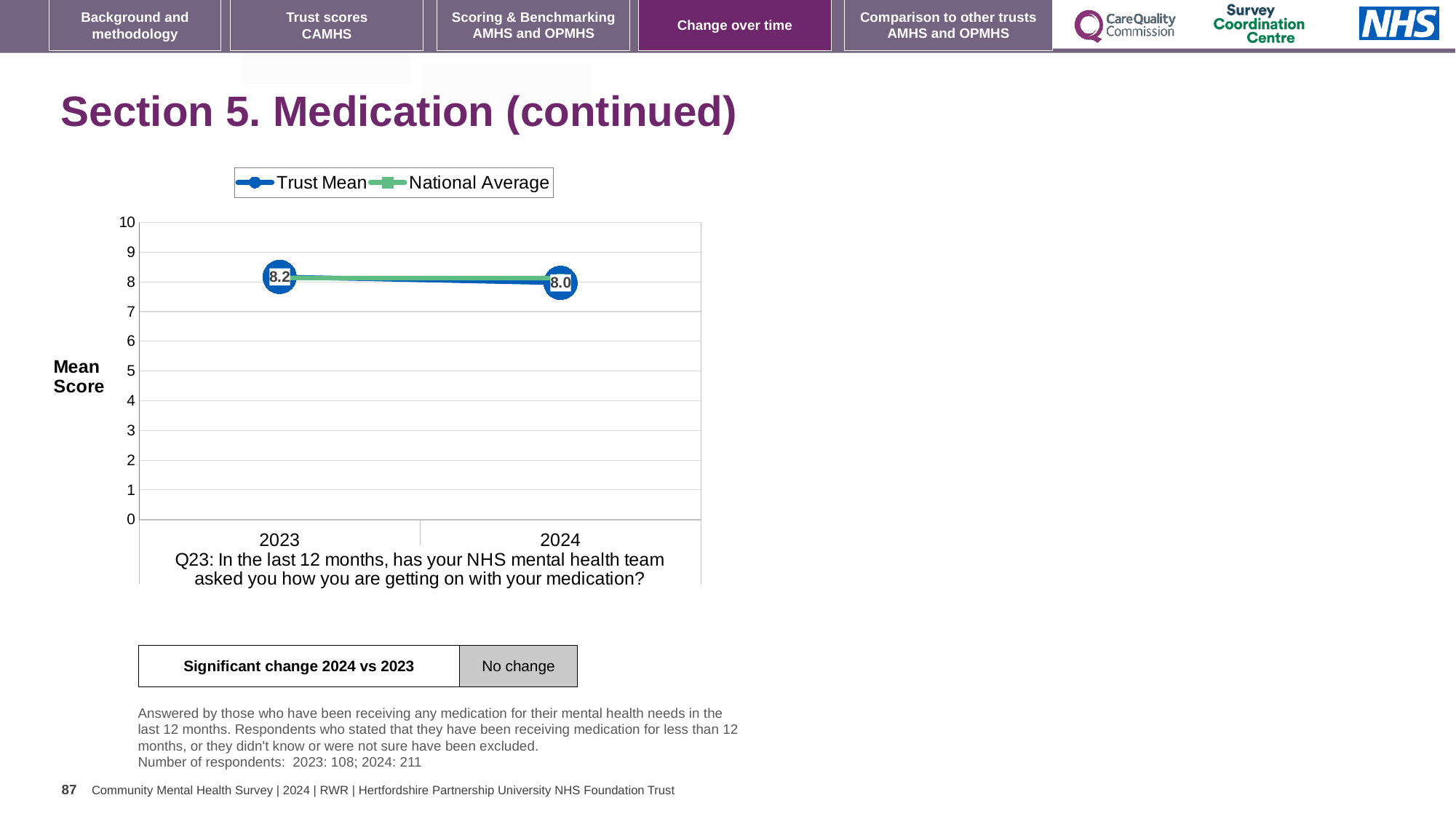
Which year has the higher Trust Mean, 2023 or 2024? 2023 Is the Trust Mean value for 2023 greater or less than 9? less What is the Trust Mean value for 2024? 8.0 What are the two series named in the chart legend? Trust Mean and National Average What is the label of the y axis of the chart? Mean Score Does the Trust Mean rise or fall from 2023 to 2024? fall What is the Trust Mean value for 2023? 8.2 How many series does the chart legend list? 2 Is the National Average value for 2024 greater or less than 5? greater What is the difference between the Trust Mean in 2023 and in 2024? 0.2 How many years are shown on the x axis of the chart? 2 What kind of chart is shown on the slide? line chart